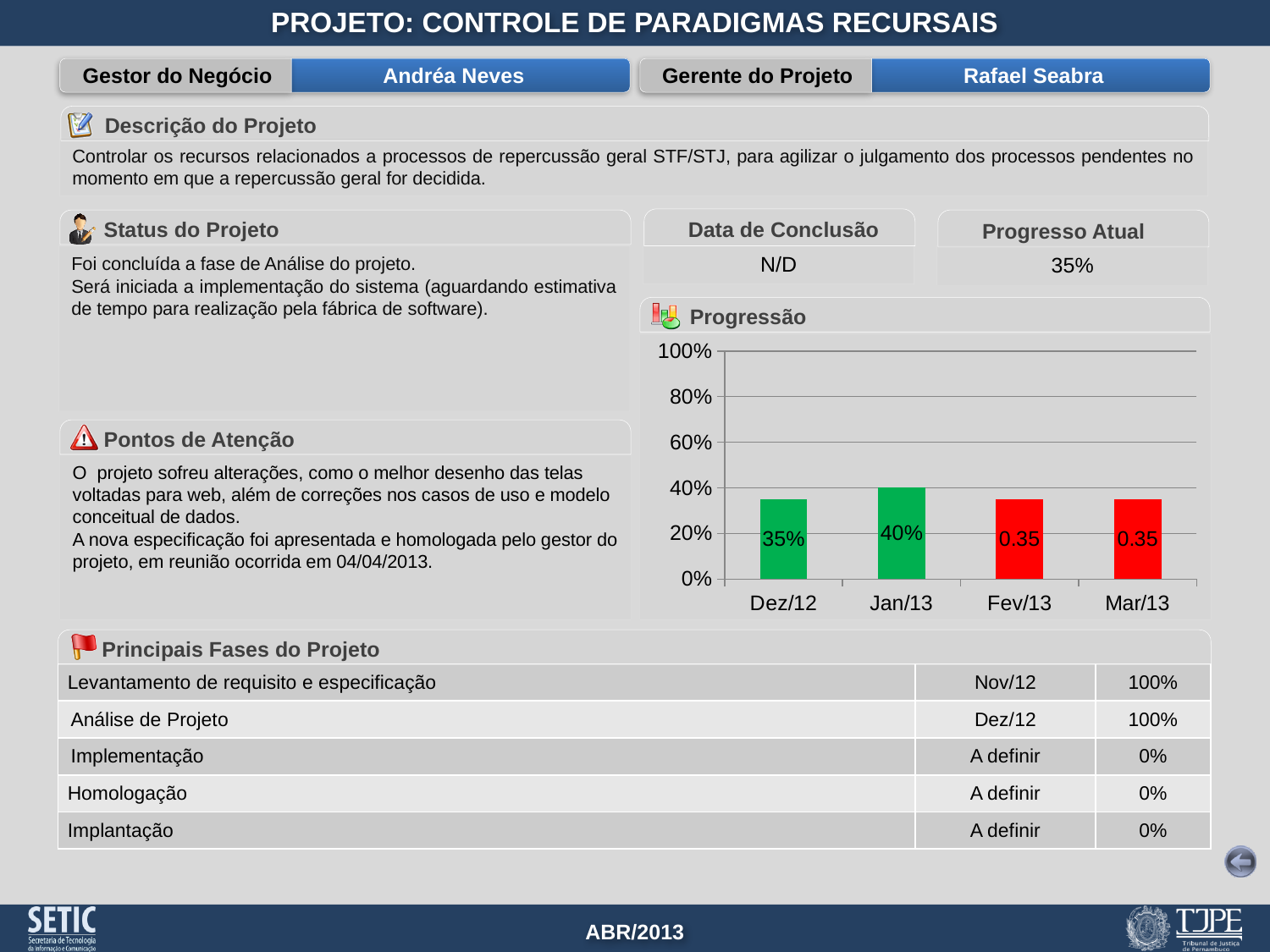
In the Progressão chart, what is the data label shown on the Fev/13 bar? 0.35 In the Progressão chart, does the value rise or fall from Dez/12 to Jan/13? rise In the Progressão chart, which is larger, the value for Jan/13 or the value for Dez/12? Jan/13 In the Progressão chart, is the value for Jan/13 greater or less than 60%? less In the Progressão chart, what is the value for Dez/12? 35% In the Progressão chart, what is the difference between the Jan/13 value and the Dez/12 value? 5% In the Progressão chart, what is the data label shown on the Mar/13 bar? 0.35 In the Progressão chart, what colour are the bars for Fev/13 and Mar/13? red In the Progressão chart, which month has the highest bar? Jan/13 What kind of chart is the Progressão chart? bar chart How many months are shown on the x axis of the Progressão chart? 4 In the Progressão chart, what is the value for Jan/13? 40%